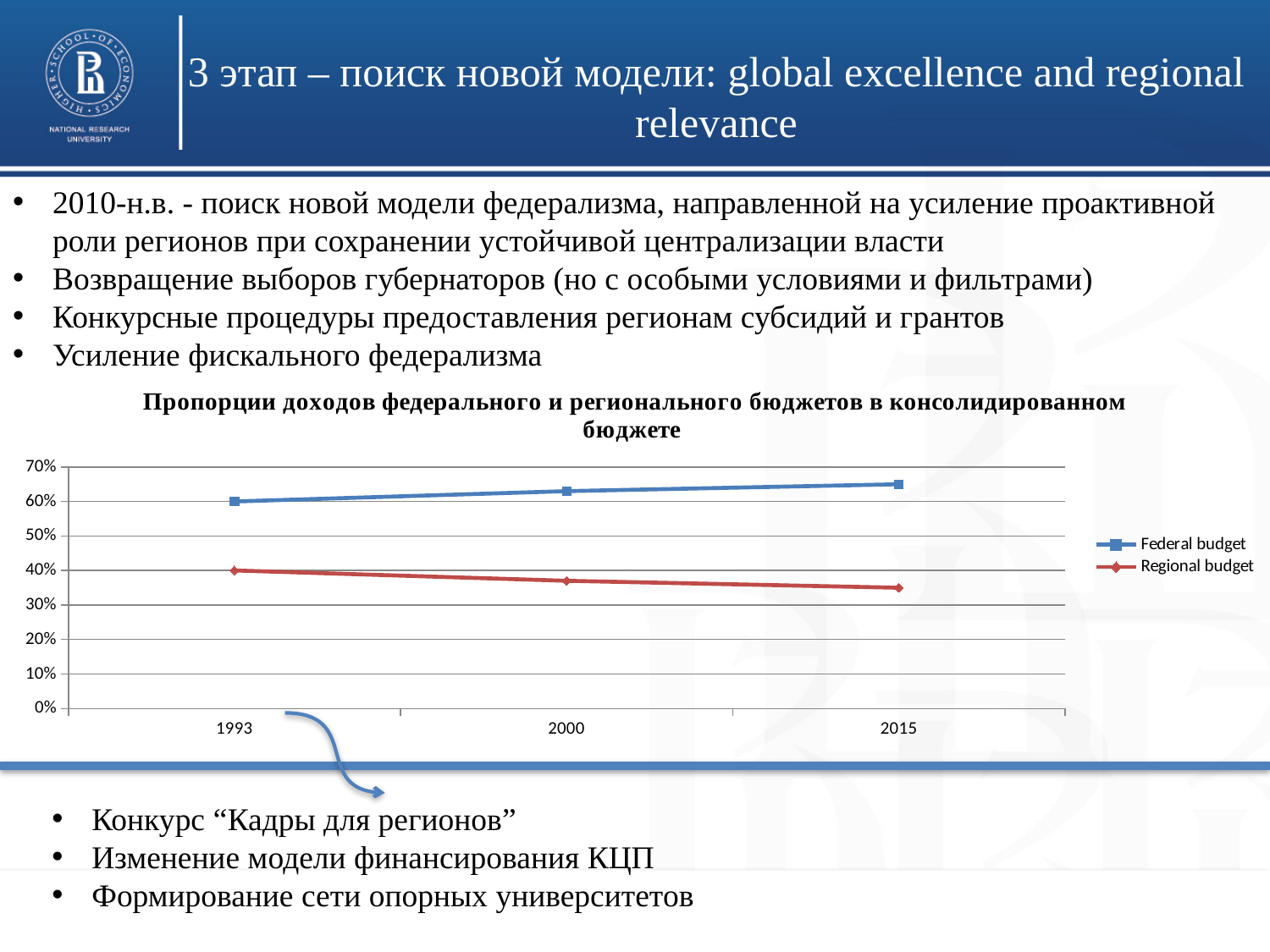
Is the value for Regional budget in 2015 greater or less than 40%? less What is the value for Federal budget in 1993? 60% How many series does the chart legend list? 2 Which series is drawn in red on the chart? Regional budget Which series has the higher value in 2015, Federal budget or Regional budget? Federal budget Does the Federal budget series rise or fall from 1993 to 2015? rise Is the value for Federal budget in 2015 greater or less than 60%? greater What is the value for Regional budget in 1993? 40% What kind of chart is shown on the slide? line chart How many years are plotted along the x axis of the chart? 3 Does the Regional budget series rise or fall from 1993 to 2015? fall Is the value for Regional budget in 2000 greater or less than 30%? greater